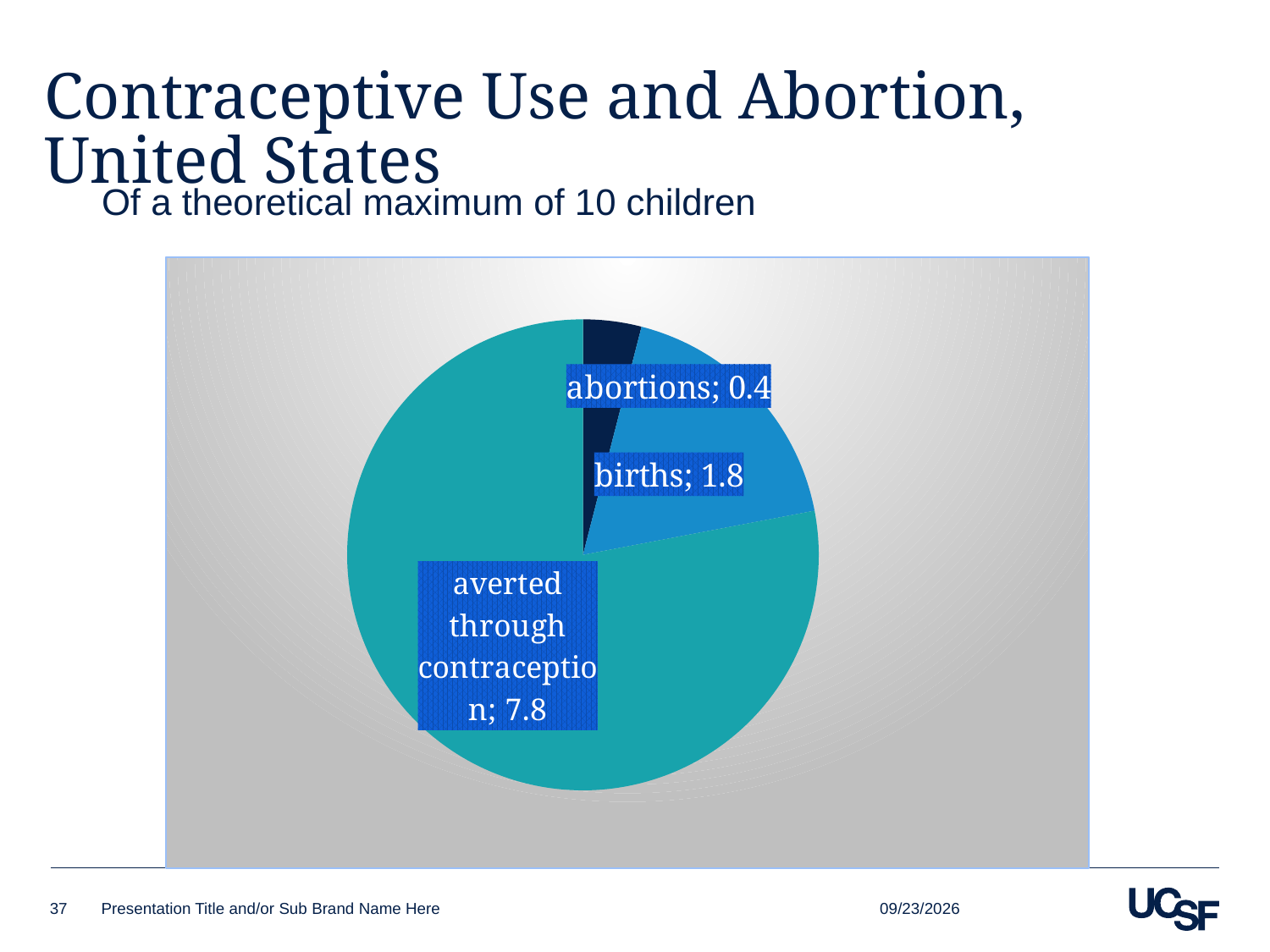
What is the value for abortions in the pie chart? 0.4 What is the difference between the values for births and abortions? 1.4 What kind of chart is shown on the slide? pie chart What share of the pie does the averted through contraception slice represent? 78% Which is larger, the value for births or the value for abortions? births Which slice of the pie chart is the largest? averted through contraception Which slice of the pie chart is the smallest? abortions How many slices does the pie chart have? 3 What is the subtitle shown above the pie chart? Of a theoretical maximum of 10 children What is the difference between the values for averted through contraception and births? 6.0 What is the value for averted through contraception in the pie chart? 7.8 What is the value for births in the pie chart? 1.8